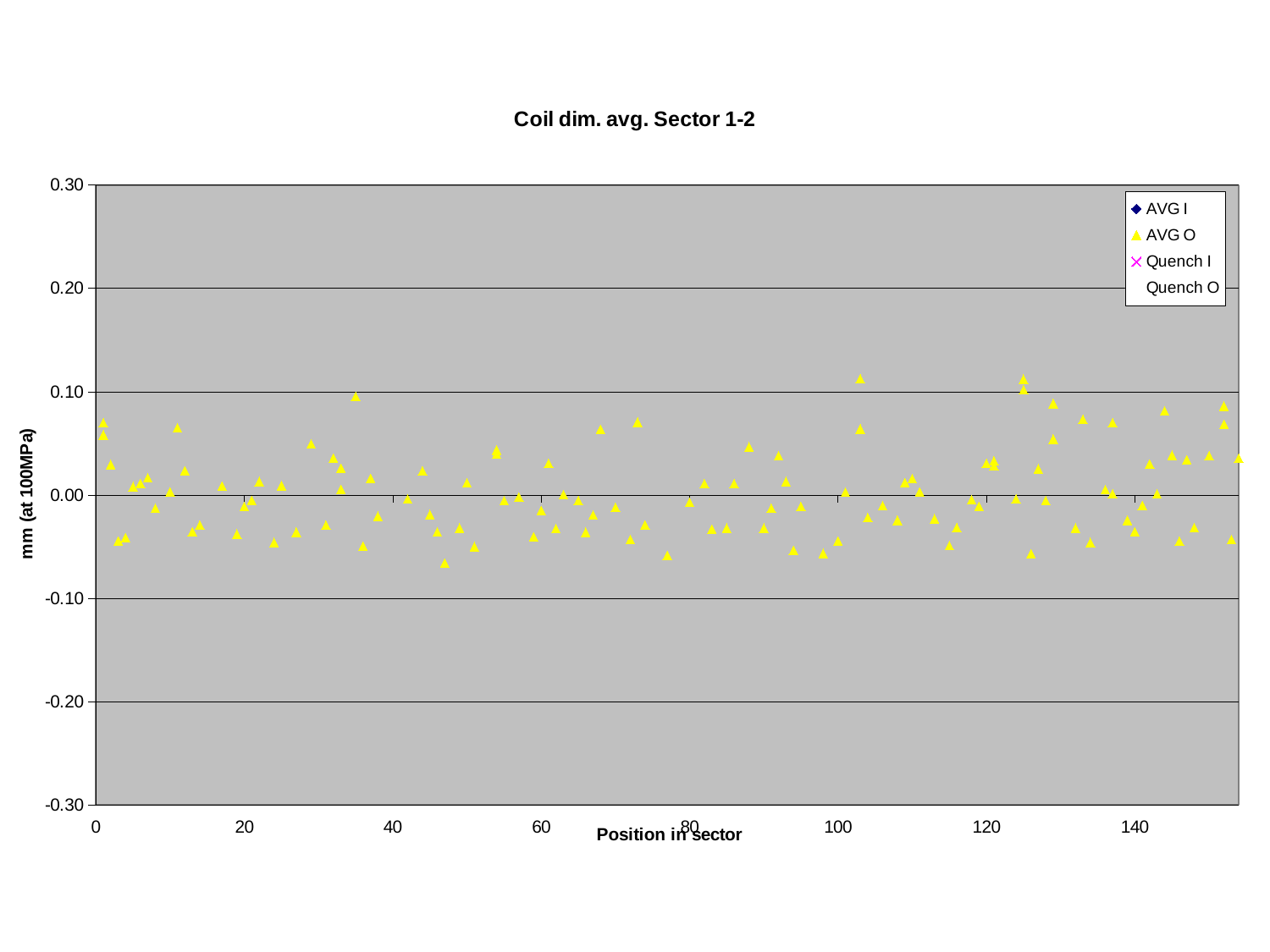
What kind of chart is shown on the slide? scatter chart Do the plotted values show a clear rising or falling trend along the x axis? no clear trend Is the lowest plotted value in the chart greater or less than -0.10? greater Is the highest plotted value in the chart greater or less than 0.20? less How many series does the legend list? 4 Is the highest plotted value in the chart greater or less than 0.10? greater What colour are the AVG O markers in the chart? yellow What is the title of the chart? Coil dim. avg. Sector 1-2